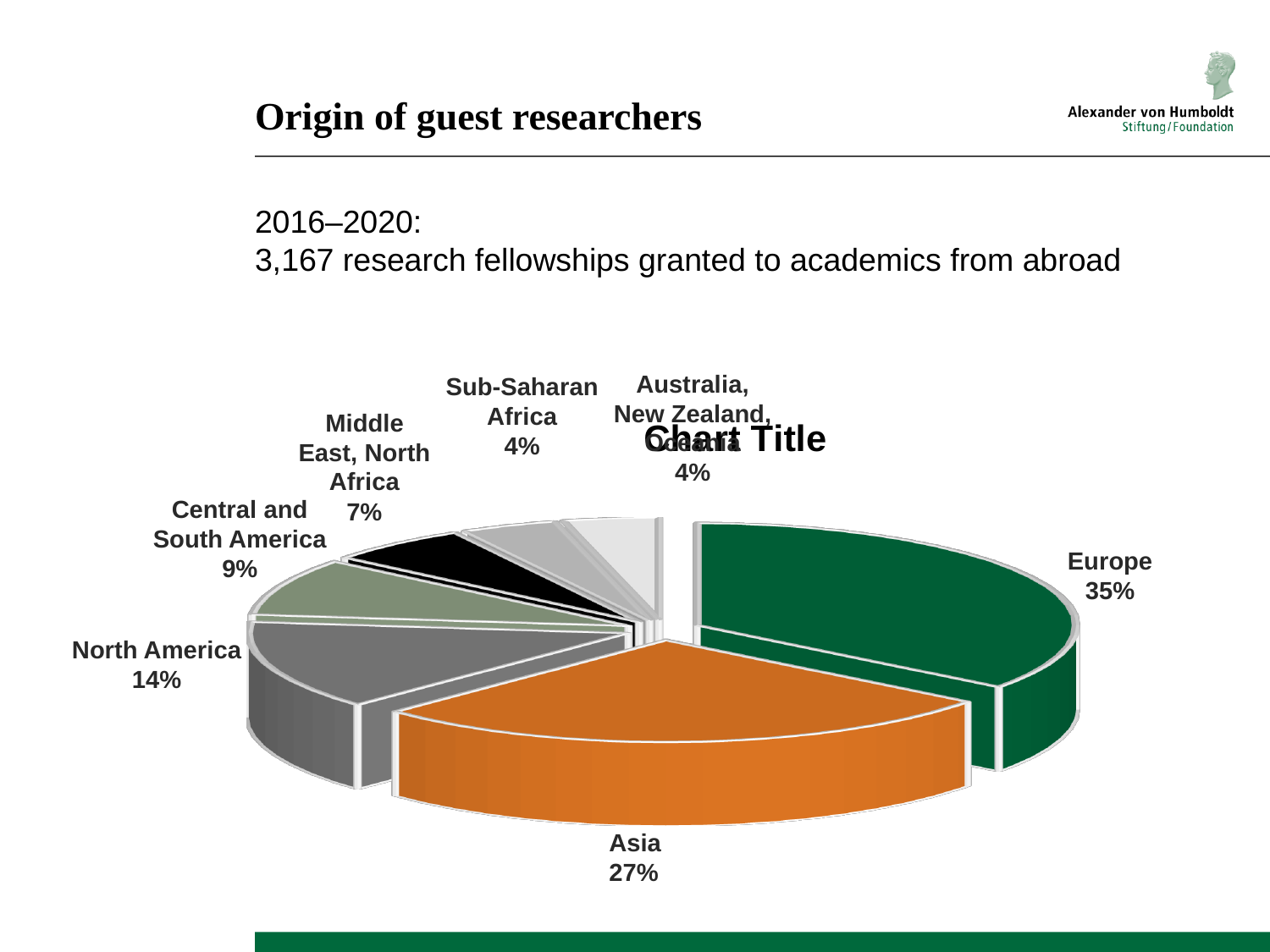
What percentage is shown for Middle East, North Africa? 7% What percentage is shown for North America? 14% What share of guest researchers comes from Europe? 35% How many slices does the pie chart have? 7 What kind of chart is shown on the slide? Pie chart Which region has the largest share of the pie? Europe What percentage is shown for Sub-Saharan Africa? 4% What is the difference in percentage points between Europe and Asia? 8 What percentage is shown for Central and South America? 9% Which is larger, the share for North America or the share for Central and South America? North America What share of guest researchers comes from Asia? 27% What colour is the Asia slice of the pie? Orange